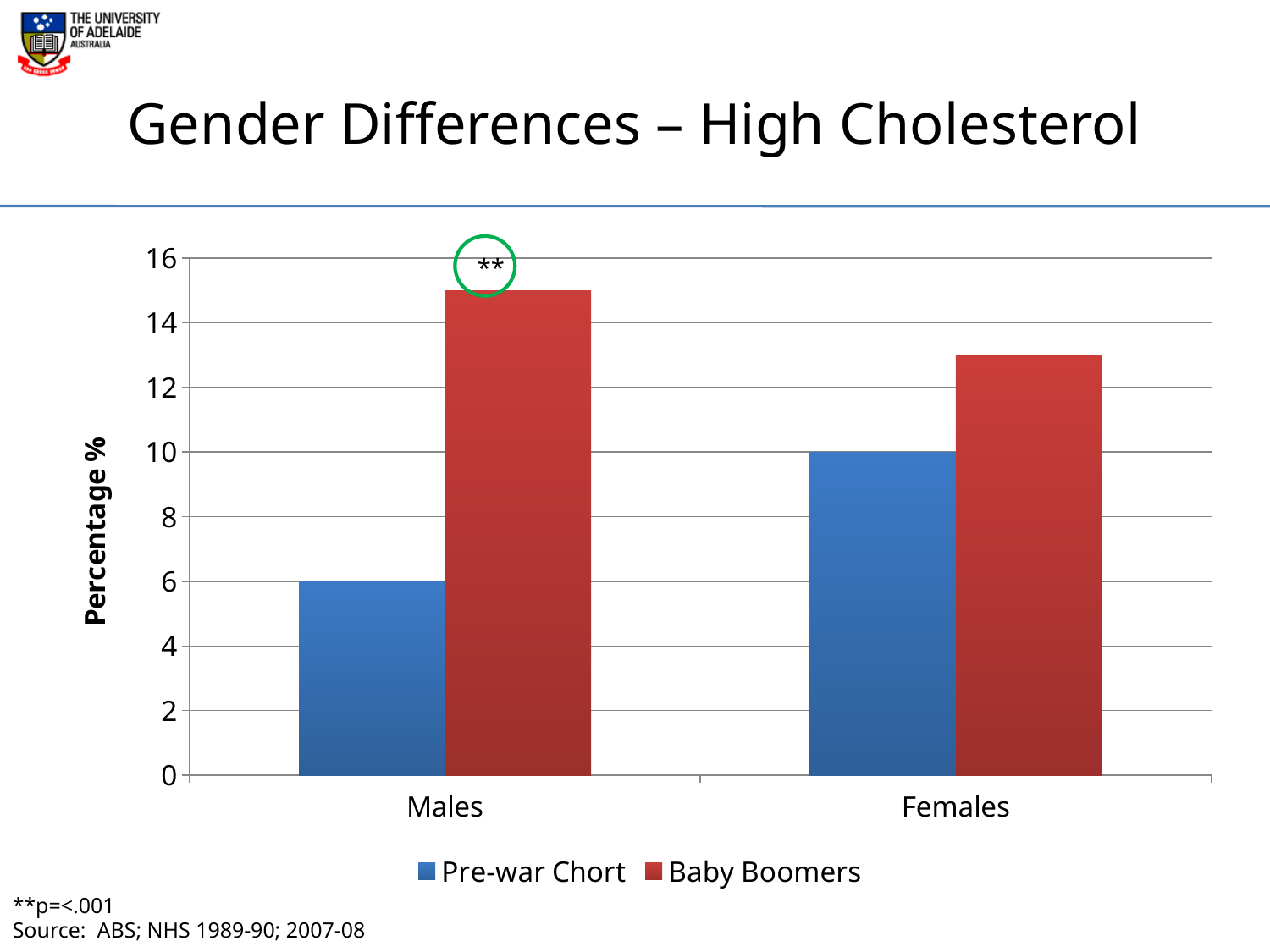
What is the label of the y axis? Percentage % Which category has the highest Baby Boomers value? Males What type of chart is shown on the slide? bar chart What is the difference between the Pre-war Chort values for Females and Males? 4 Is the value for Baby Boomers for Females greater or less than 14? less What is the value for the Pre-war Chort series for Females? 10 How many series does the legend list? 2 How many categories are shown on the x axis? 2 What is the value for the Pre-war Chort series for Males? 6 Is the value for Baby Boomers for Males greater or less than 14? greater Which category has the lowest Pre-war Chort value? Males Which is larger for Females: the Pre-war Chort value or the Baby Boomers value? Baby Boomers